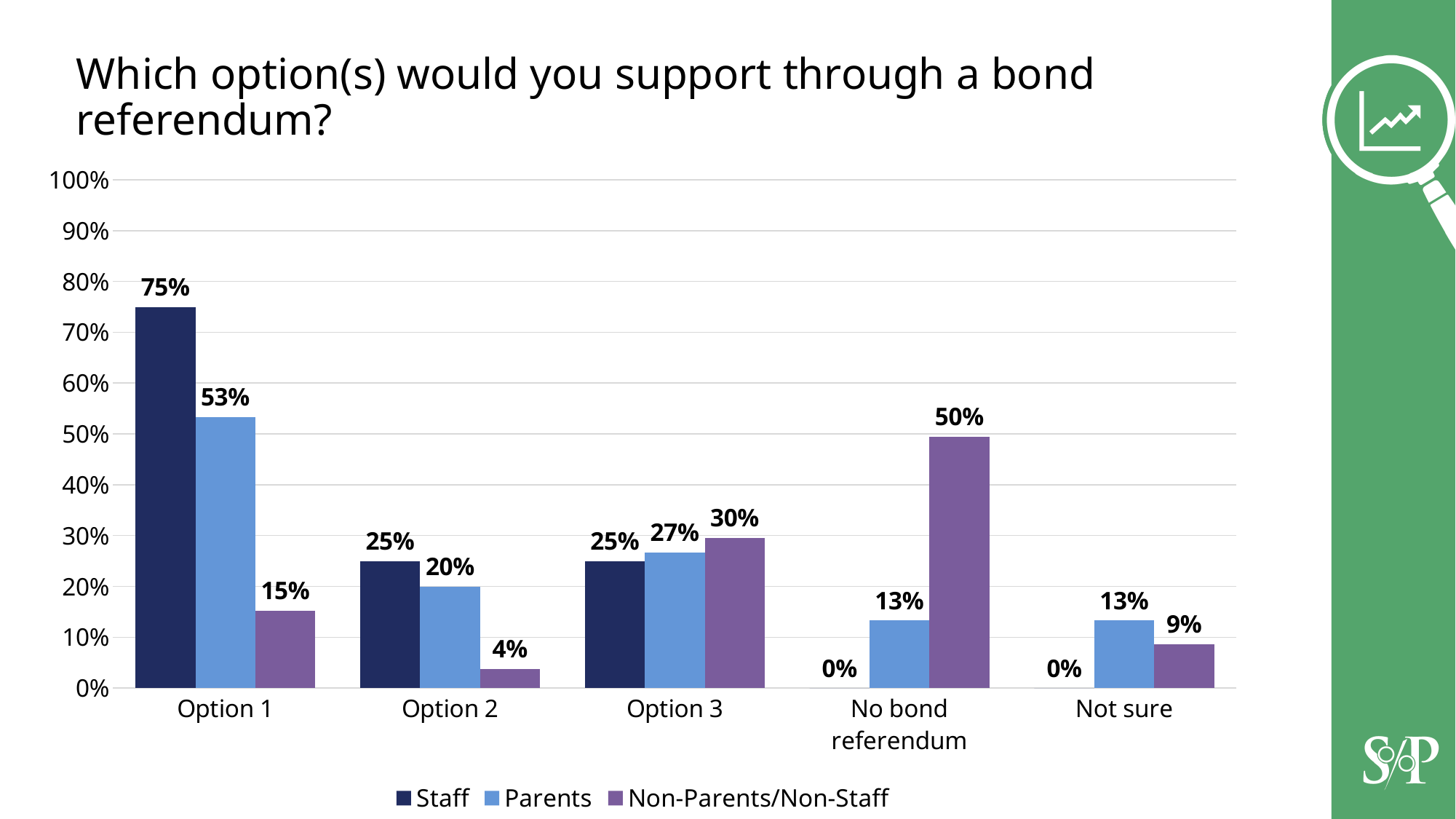
How many series does the legend list? 3 What percentage of Non-Parents/Non-Staff chose 'No bond referendum'? 50% What is the Staff value for 'Not sure'? 0% How many categories are shown on the x axis? 5 What kind of chart is shown on the slide? Bar chart What is the difference between the Staff and Parents values for Option 1? 22% What percentage of Staff support Option 1? 75% Which category has the lowest value for the Parents series? No bond referendum and Not sure (both 13%) What is the title of the chart? Which option(s) would you support through a bond referendum? Which is larger for Option 2: the Parents value or the Non-Parents/Non-Staff value? Parents What percentage of Parents support Option 3? 27% Which category has the highest value for the Non-Parents/Non-Staff series? No bond referendum